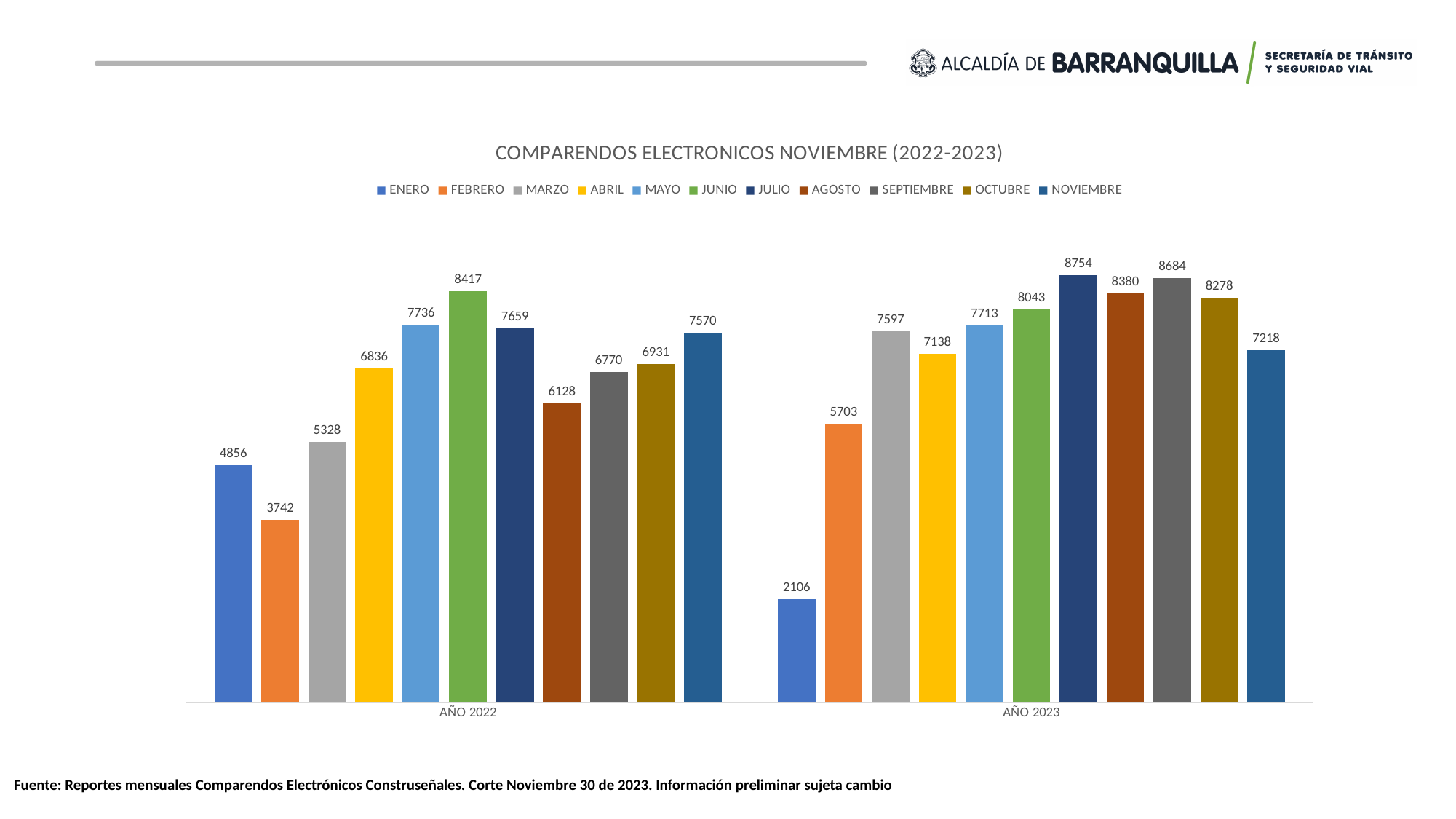
What is the difference between JULIO in AÑO 2023 and JULIO in AÑO 2022? 1095 What is the value for ENERO in AÑO 2023? 2106 What is the value for NOVIEMBRE in AÑO 2023? 7218 What type of chart is shown on the slide? Bar chart What is the value for NOVIEMBRE in AÑO 2022? 7570 What is the difference between the NOVIEMBRE values for AÑO 2022 and AÑO 2023? 352 Which month has the highest value in AÑO 2023? JULIO How many series does the legend list? 11 Which is larger: AGOSTO in AÑO 2022 or AGOSTO in AÑO 2023? AGOSTO in AÑO 2023 How many categories are shown on the x axis? 2 Which month has the lowest value in AÑO 2022? FEBRERO Which month has the highest value in AÑO 2022? JUNIO